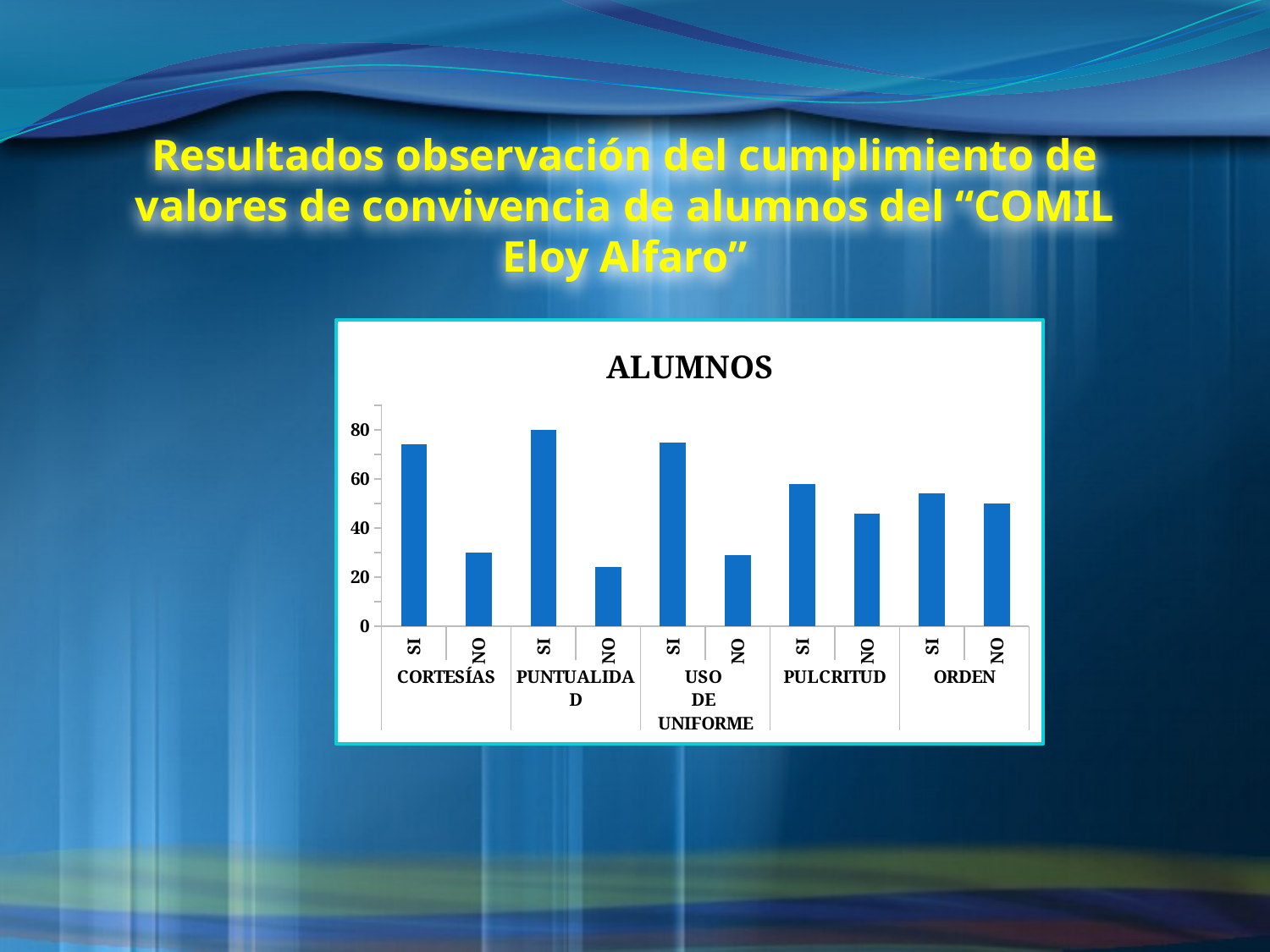
Which bar is the highest in the chart? PUNTUALIDAD SI Is the value for CORTESÍAS NO greater or less than 40? less Which bar is the lowest in the chart? PUNTUALIDAD NO Which is larger, the SI bar or the NO bar for PULCRITUD? SI How many bars are plotted in the chart? 10 How many value categories (CORTESÍAS, PUNTUALIDAD, etc.) are shown along the x axis? 5 What kind of chart is shown on the slide? bar chart Which is larger, the SI bar or the NO bar for USO DE UNIFORME? SI Is the value for ORDEN SI greater or less than 60? less What is the title of the chart? ALUMNOS Is the value for PULCRITUD NO greater or less than 40? greater